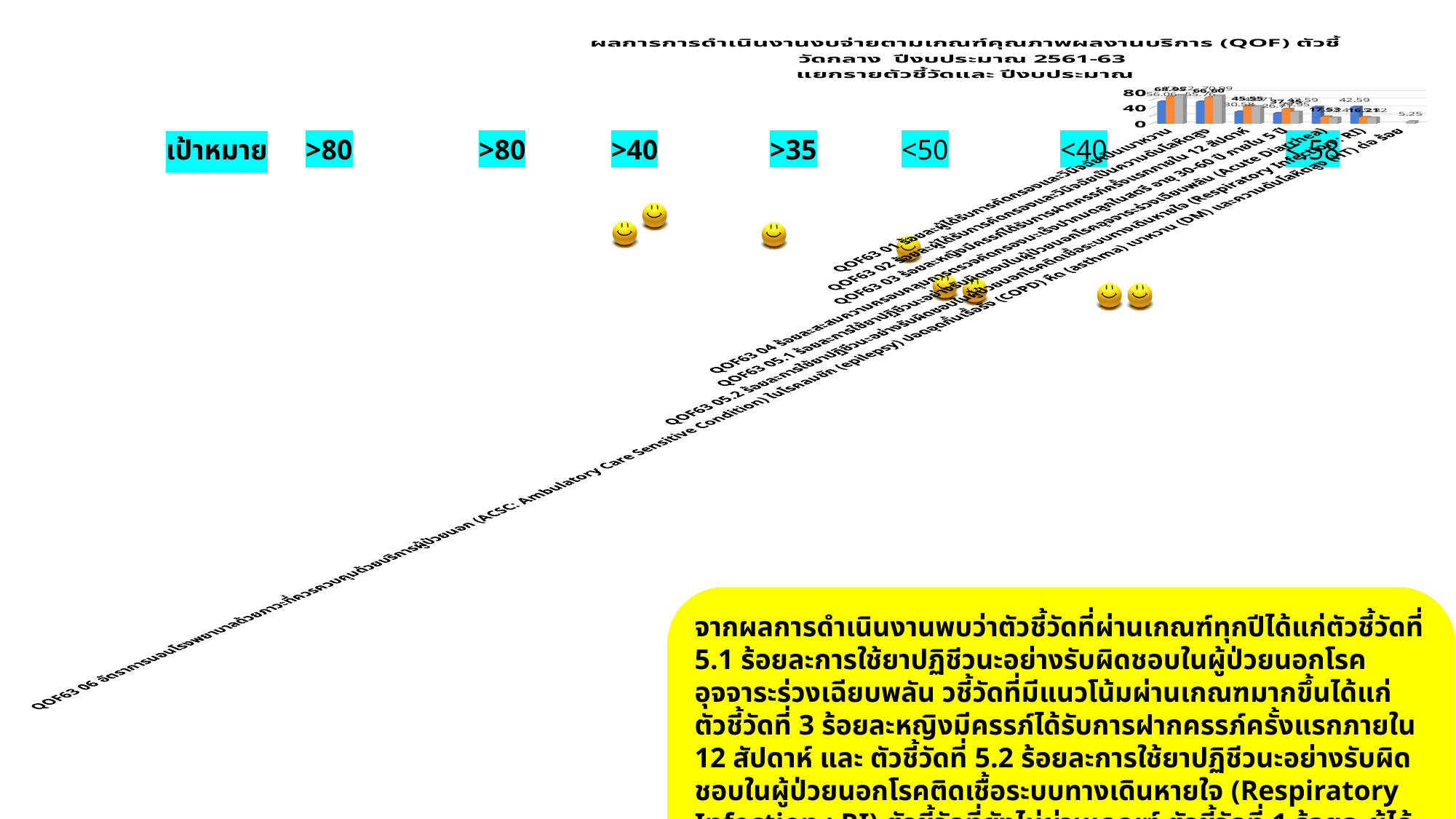
How many QOF63 indicator categories are plotted on the chart? 7 Which fiscal years does the chart title say the QOF results cover? 2561-63 What is the highest tick value shown on the chart's value axis? 80 Are the values for the last category, QOF63 06, greater or less than 40? less What kind of chart is shown on the slide? bar chart